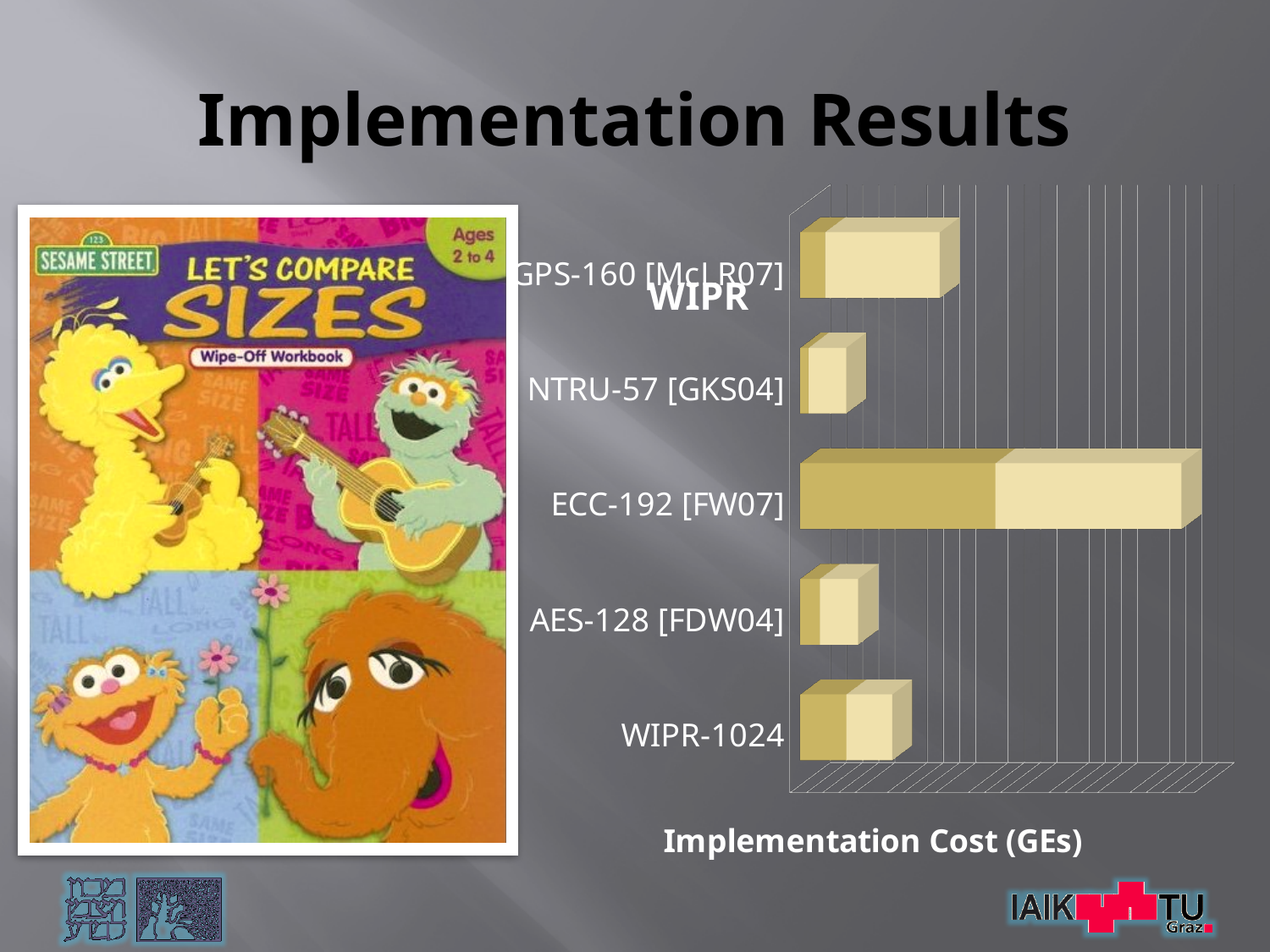
What kind of chart is shown on the slide? bar chart How many categories are plotted in the chart? 5 Which has the larger implementation cost, GPS-160 [McLR07] or AES-128 [FDW04]? GPS-160 [McLR07] Which category has the highest implementation cost in the chart? ECC-192 [FW07] What is the axis title shown below the chart? Implementation Cost (GEs) Which category is listed at the bottom of the chart? WIPR-1024 Which has the larger implementation cost, ECC-192 [FW07] or GPS-160 [McLR07]? ECC-192 [FW07] Which has the larger implementation cost, ECC-192 [FW07] or WIPR-1024? ECC-192 [FW07]